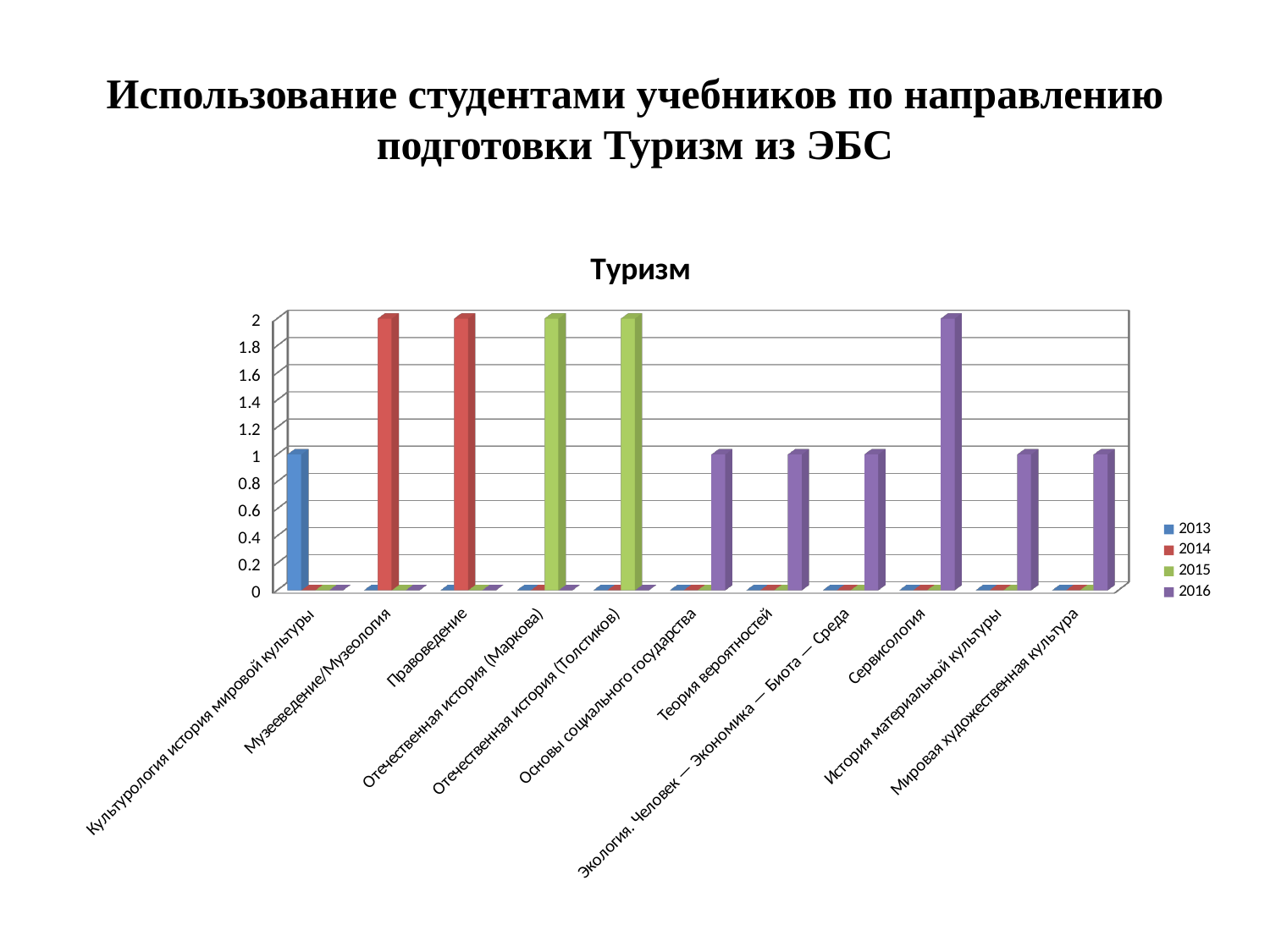
How many series does the legend list? 4 What is the difference between the 2014 value for Музееведение/Музеология and the 2013 value for Культурология история мировой культуры? 1 Which is larger: the 2016 value for Сервисология or the 2016 value for История материальной культуры? Сервисология What is the value for 2013 for Культурология история мировой культуры? 1 What is the value for 2015 for Отечественная история (Маркова)? 2 What is the value for 2016 for Сервисология? 2 Which series is shown in purple in the legend? 2016 How many categories are shown on the x axis? 11 What is the value for 2016 for Теория вероятностей? 1 What kind of chart is shown on the slide? Bar chart What is the value for 2014 for Правоведение? 2 What is the title of the chart? Туризм